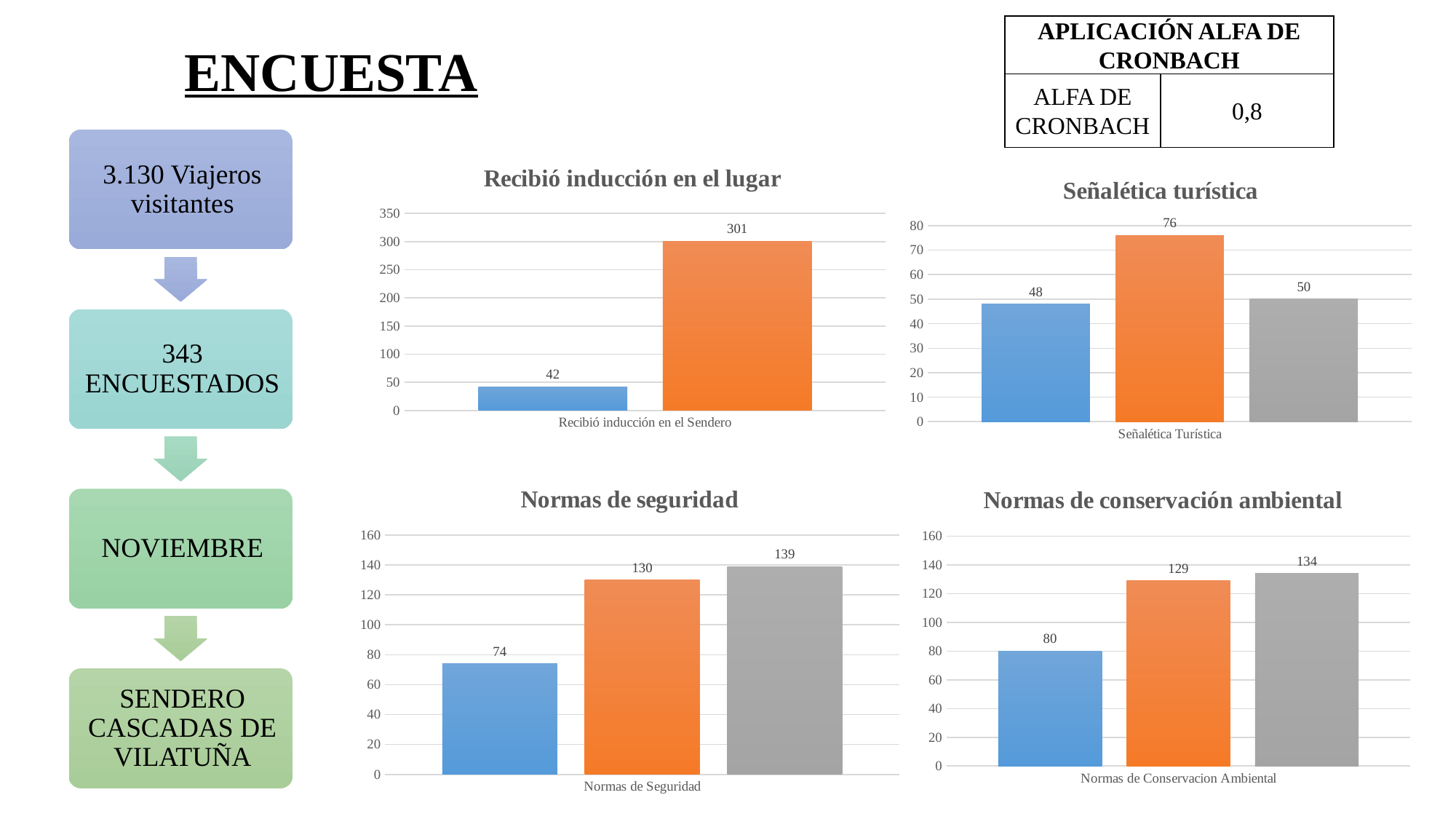
In the 'Normas de conservación ambiental' chart, what is the value of the orange bar? 129 In the 'Normas de seguridad' chart, which bar has the lowest value? The blue bar (74) In the 'Recibió inducción en el lugar' chart, how many bars are plotted? 2 In the 'Recibió inducción en el lugar' chart, what is the difference between the orange bar and the blue bar? 259 In the 'Normas de seguridad' chart, what is the value of the grey bar? 139 In the 'Señalética turística' chart, what is the value of the blue bar? 48 In the 'Señalética turística' chart, which bar has the highest value? The orange bar (76) In the 'Normas de conservación ambiental' chart, is the grey bar or the blue bar larger? The grey bar What type of chart is 'Normas de conservación ambiental'? Bar chart In the 'Normas de seguridad' chart, what is the difference between the grey bar and the orange bar? 9 In the 'Señalética turística' chart, what is the total of the three bars? 174 In the 'Recibió inducción en el lugar' chart, what is the value of the orange bar? 301